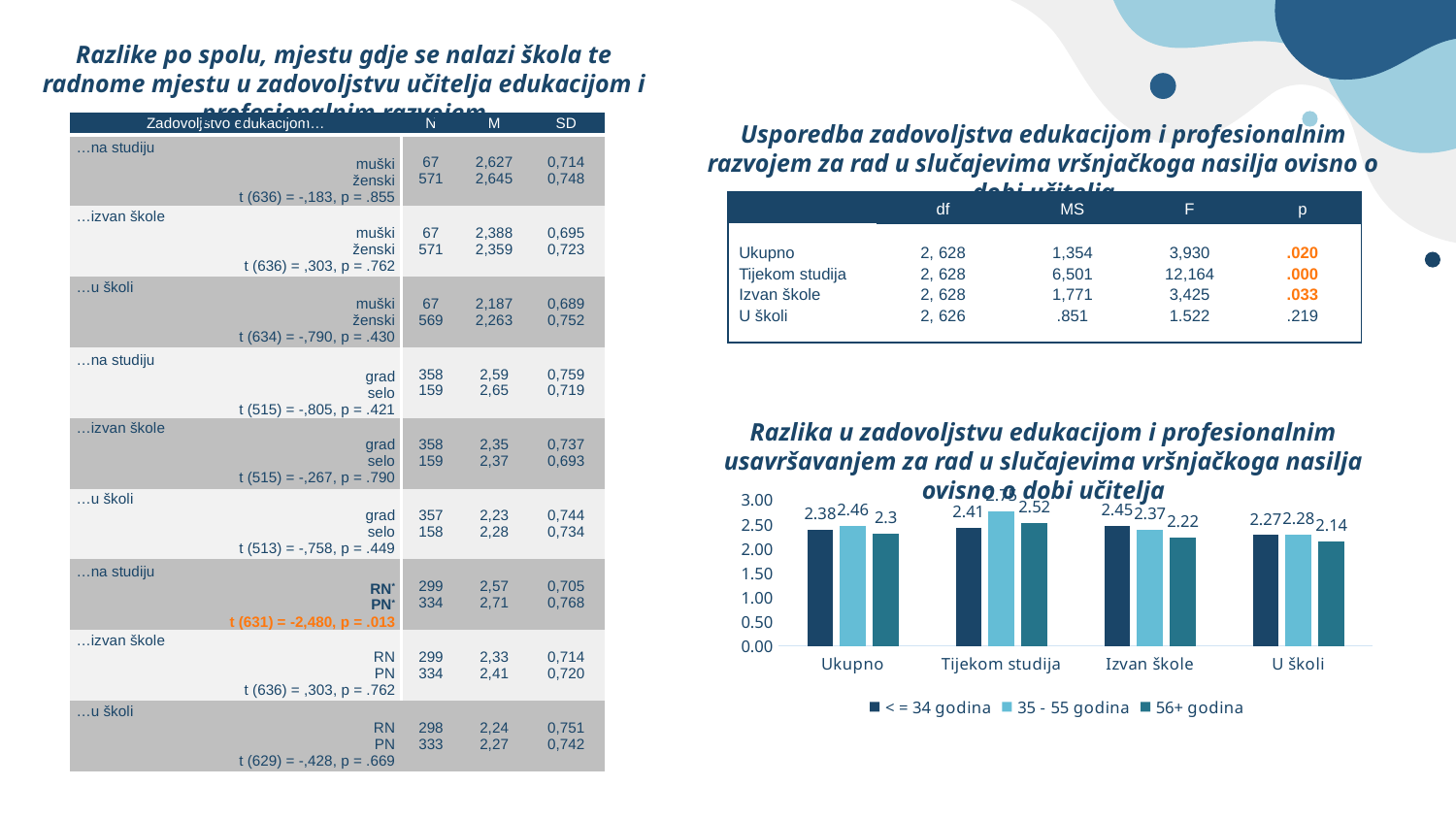
How many categories are shown on the x axis of the chart? 4 Across all categories, in which category does the '56+ godina' series have its lowest value? U školi What is the value for the '35 - 55 godina' series in the 'U školi' category? 2.28 Is the value for '35 - 55 godina' in the 'Tijekom studija' category greater or less than 2.50? greater What is the value for the '< = 34 godina' series in the 'Ukupno' category? 2.38 What is the difference between the '< = 34 godina' and '56+ godina' values in the 'Izvan škole' category? 0.23 What kind of chart is shown on the slide? bar chart In the 'Ukupno' category, which age group has the lowest value? 56+ godina Which is larger: the '56+ godina' value for 'Ukupno' or the '56+ godina' value for 'U školi'? Ukupno How many series does the chart's legend list? 3 What is the value for the '56+ godina' series in the 'Izvan škole' category? 2.22 In the 'Izvan škole' category, which age group has the highest value? < = 34 godina